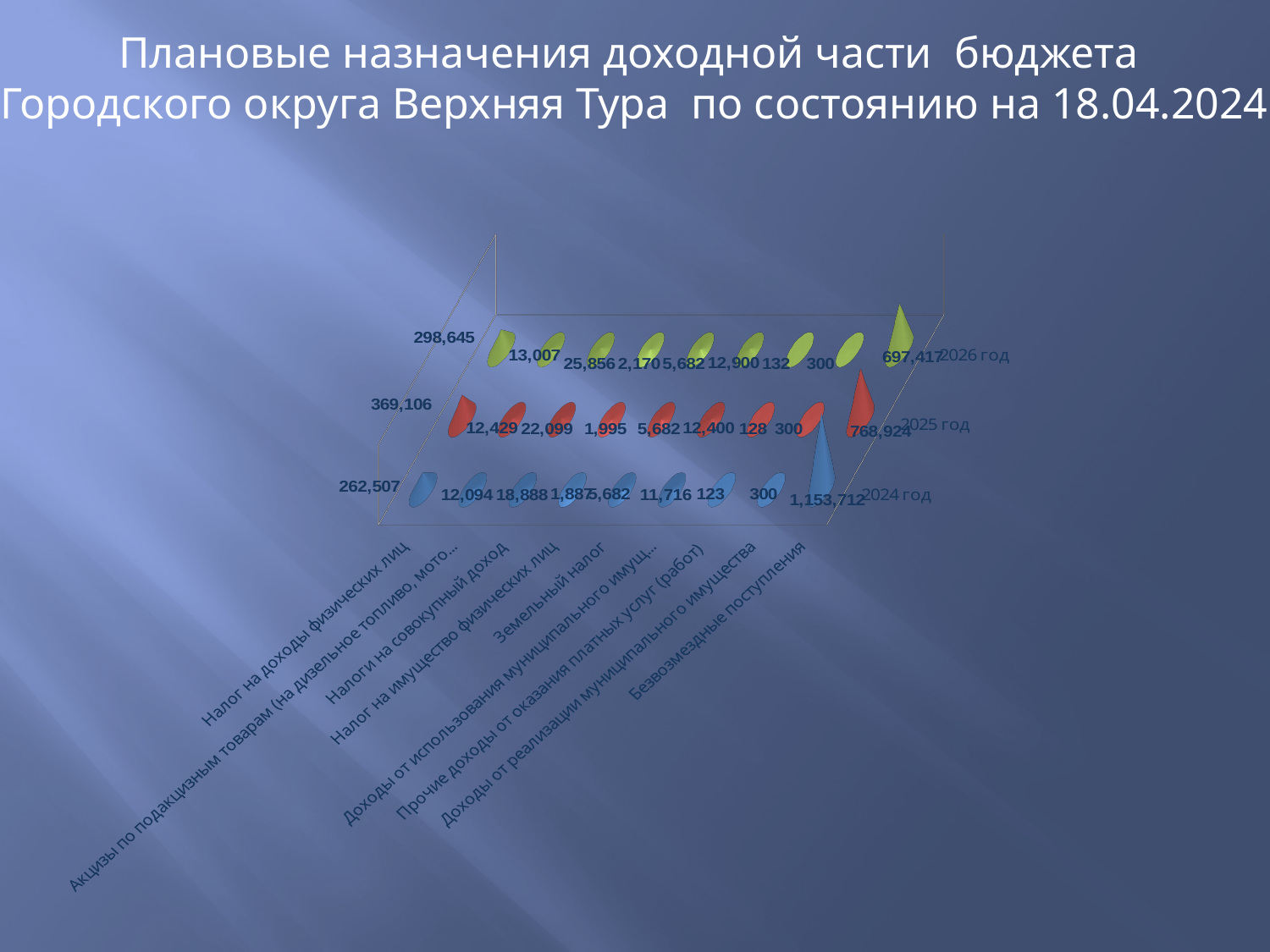
Which is larger for Безвозмездные поступления: the 2025 год value or the 2026 год value? 2025 год What is the value for Безвозмездные поступления in the 2024 год series? 1,153,712 What is the difference between the 2024 год and 2025 год values for Безвозмездные поступления? 384,788 What is the value for Земельный налог in the 2024 год series? 5,682 What is the difference between the 2025 год and 2024 год values for Налог на доходы физических лиц? 106,599 How many categories are shown on the x axis? 9 Which category has the lowest value in the 2025 год series? Прочие доходы от оказания платных услуг (работ) What is the value for Налоги на совокупный доход in the 2026 год series? 25,856 Which series is drawn in red? 2025 год How many series does the chart show? 3 Which category has the highest value in the 2024 год series? Безвозмездные поступления What is the value for Налог на доходы физических лиц in the 2025 год series? 369,106